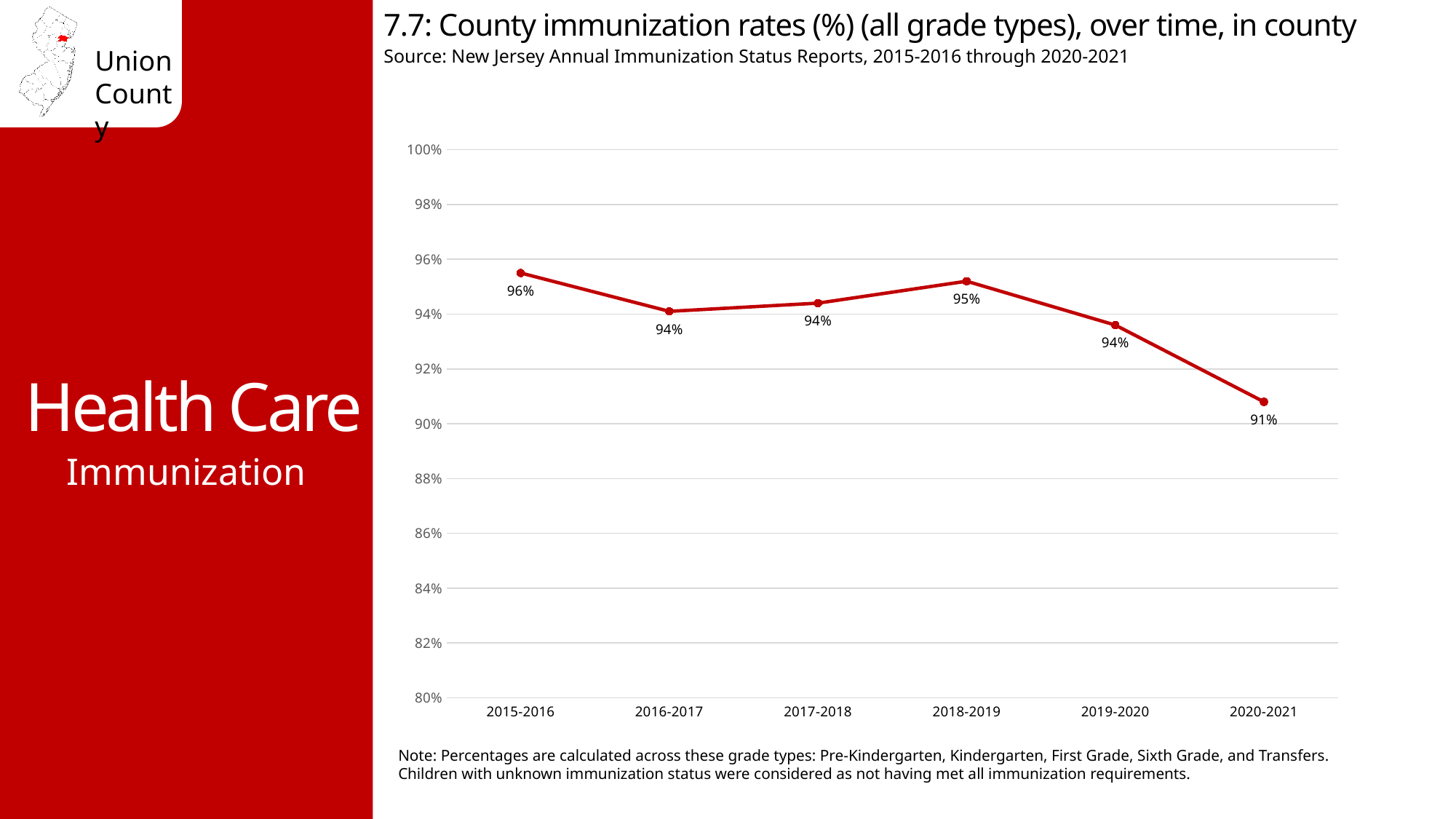
What is the county immunization rate for 2015-2016? 96% Which is larger, the immunization rate for 2018-2019 or for 2020-2021? 2018-2019 What is the county immunization rate for 2020-2021? 91% What kind of chart is shown on the slide? Line chart What is the county immunization rate for 2016-2017? 94% What is the difference between the labelled immunization rates for 2015-2016 and 2020-2021? 5 percentage points What is the county immunization rate for 2018-2019? 95% Which school year has the highest immunization rate? 2015-2016 Is the immunization rate for 2020-2021 greater or less than 92%? less How many school years are plotted on the chart? 6 Overall, do the immunization rates rise or fall from 2015-2016 to 2020-2021? Fall Which school year has the lowest immunization rate? 2020-2021